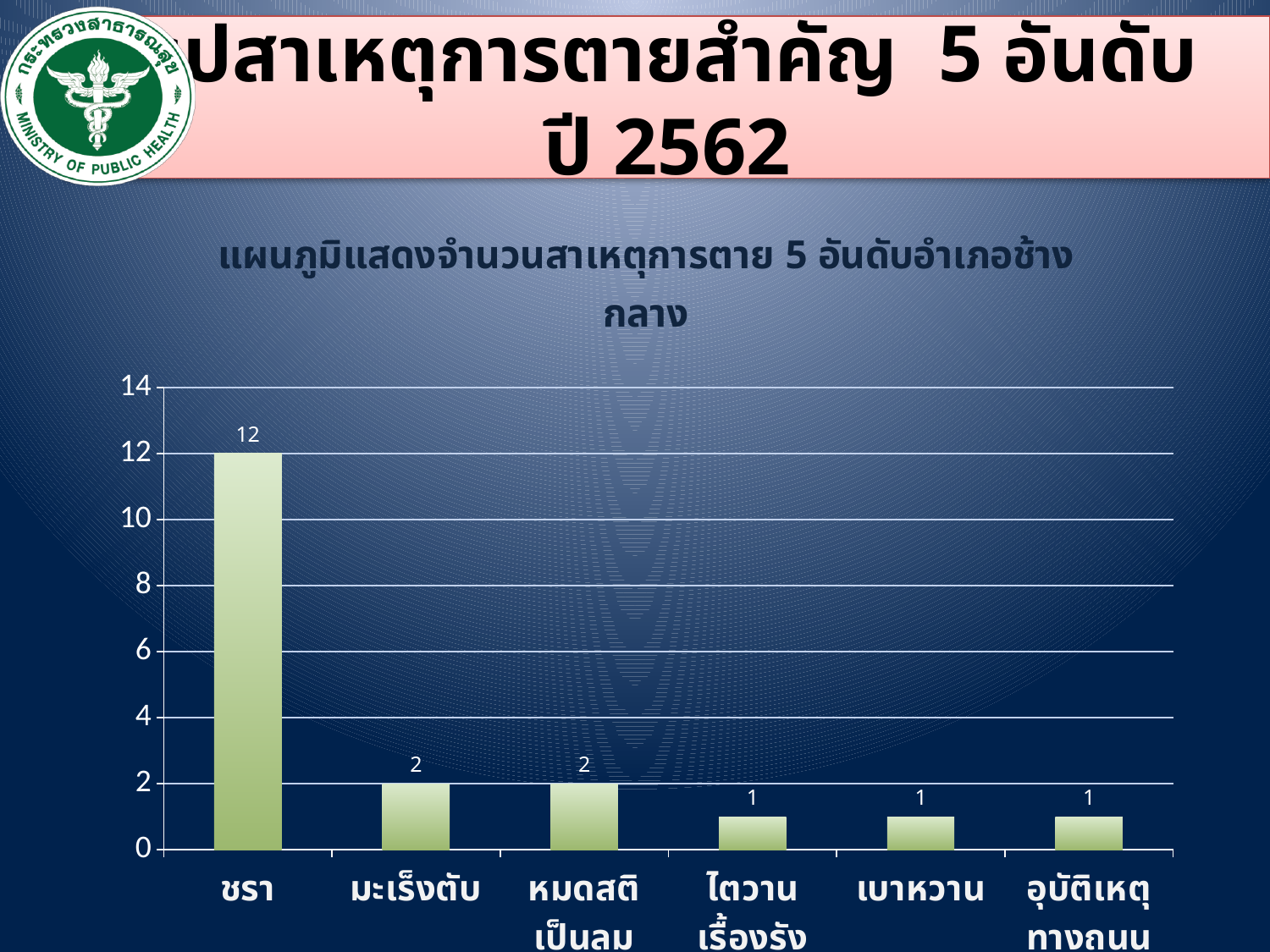
What is the highest value shown on the vertical axis? 14 What is the value for ชรา? 12 What is the difference between the values for ชรา and มะเร็งตับ? 10 Is the value for ชรา greater or less than 10? greater Which category has the highest value? ชรา What is the value for อุบัติเหตุทางถนน? 1 What is the value for มะเร็งตับ? 2 What kind of chart is shown on the slide? Bar chart How many categories are shown on the x axis? 6 What is the title of the chart? แผนภูมิแสดงจำนวนสาเหตุการตาย 5 อันดับอำเภอช้างกลาง Which is larger, the value for หมดสติเป็นลม or the value for ไตวานเรื้อรัง? หมดสติเป็นลม What is the value for เบาหวาน? 1